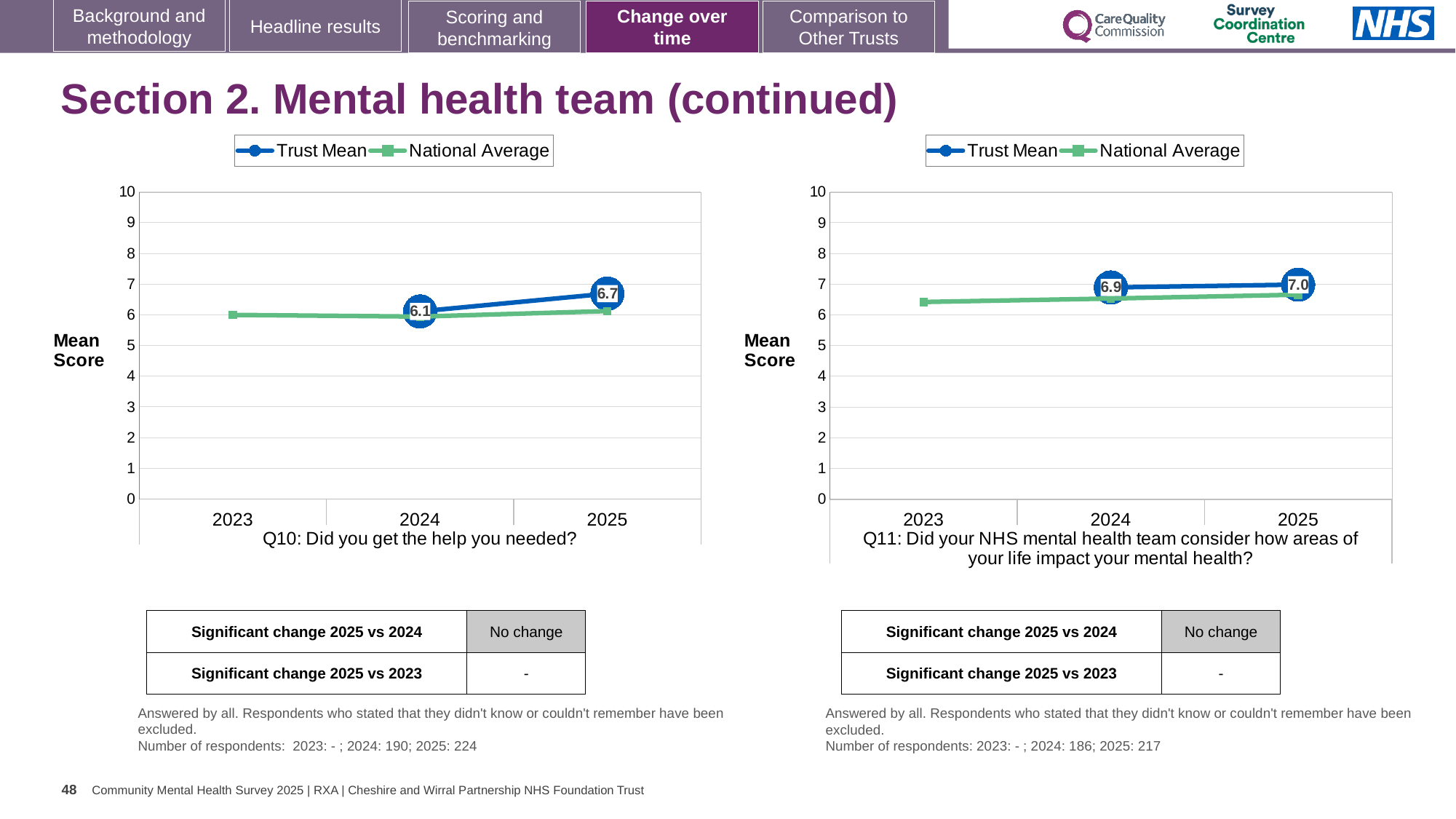
How many series does the legend of the Q11 chart (right) list? 2 What kind of chart is the Q10 chart (left)? line chart In the Q11 chart (right), what is the Trust Mean score for 2024? 6.9 In the Q11 chart (right), what is the Trust Mean score for 2025? 7.0 In the Q10 chart (left), what is the Trust Mean score for 2024? 6.1 In the Q10 chart (left), is the National Average for 2023 greater or less than 7? less In the Q10 chart (left), does the Trust Mean rise or fall from 2024 to 2025? rise In the Q11 chart (right), what is the difference between the Trust Mean in 2025 and in 2024? 0.1 In the Q10 chart (left), by how much did the Trust Mean increase from 2024 to 2025? 0.6 In the Q10 chart (left), what is the Trust Mean score for 2025? 6.7 In the Q11 chart (right), is the National Average for 2023 greater or less than 5? greater In the Q10 chart (left), which is larger in 2025, the Trust Mean or the National Average? Trust Mean